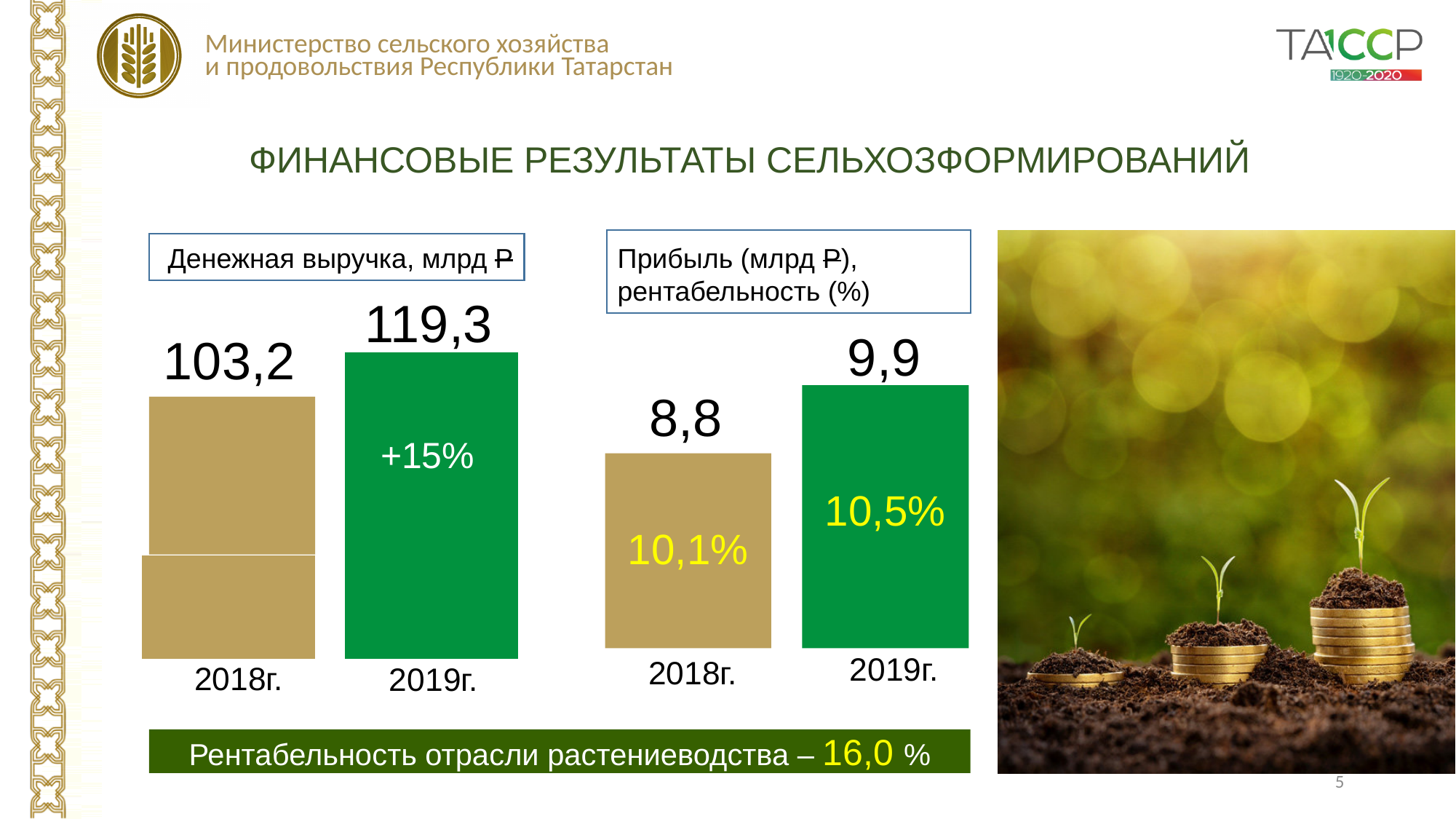
In the 'Денежная выручка, млрд ₽' chart, what is the value for 2019г.? 119,3 In the 'Прибыль (млрд ₽), рентабельность (%)' chart, what is the profit value for 2018г.? 8,8 In the 'Денежная выручка, млрд ₽' chart, which year has the higher value? 2019г. In the 'Прибыль (млрд ₽), рентабельность (%)' chart, what is the difference in profit between 2019г. and 2018г.? 1,1 How many bars does the 'Денежная выручка, млрд ₽' chart have? 2 In the 'Прибыль (млрд ₽), рентабельность (%)' chart, what profitability percentage is printed on the 2019г. bar? 10,5% In the 'Прибыль (млрд ₽), рентабельность (%)' chart, what profitability percentage is printed on the 2018г. bar? 10,1% In the 'Денежная выручка, млрд ₽' chart, what is the difference between the 2019г. and 2018г. values? 16,1 In the 'Денежная выручка, млрд ₽' chart, what percentage change is printed on the 2019г. bar? +15% In the 'Прибыль (млрд ₽), рентабельность (%)' chart, what is the profit value for 2019г.? 9,9 In the 'Денежная выручка, млрд ₽' chart, what is the value for 2018г.? 103,2 What type of chart is the 'Прибыль (млрд ₽), рентабельность (%)' chart? bar chart